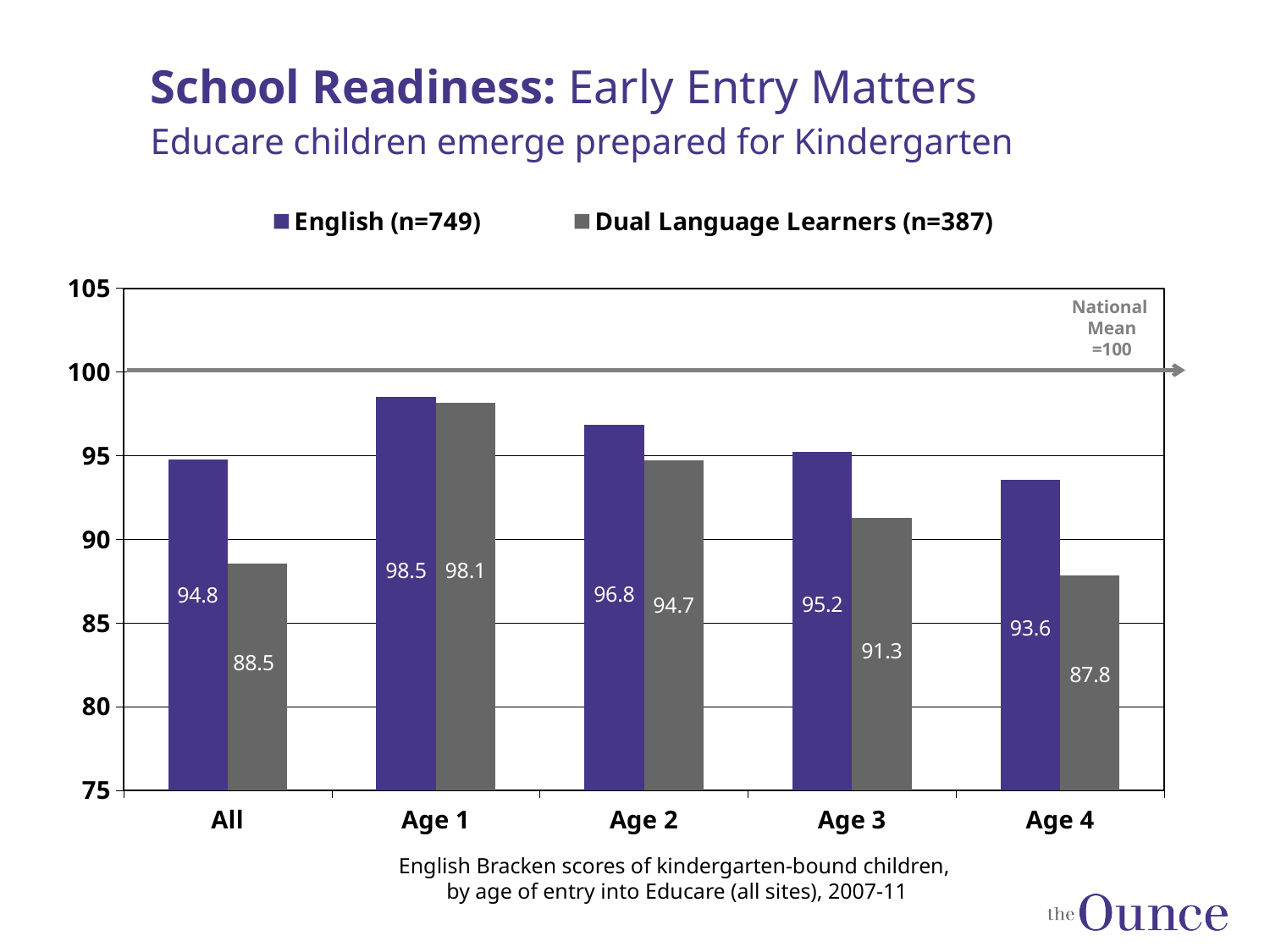
What is the Dual Language Learners score for the All category? 88.5 Which is larger, the English score for Age 2 or the English score for Age 4? Age 2 Which category has the lowest Dual Language Learners score? Age 4 How many series does the legend list? 2 What is the English score for Age 1? 98.5 Do the Dual Language Learners scores rise or fall from Age 1 to Age 4? Fall What value does the horizontal reference line labelled National Mean represent? 100 How many categories are shown on the x axis? 5 Which age-of-entry category has the highest English score? Age 1 What is the difference between the English and Dual Language Learners scores for Age 3? 3.9 What kind of chart is shown on the slide? Bar chart What is the Dual Language Learners score for Age 4? 87.8